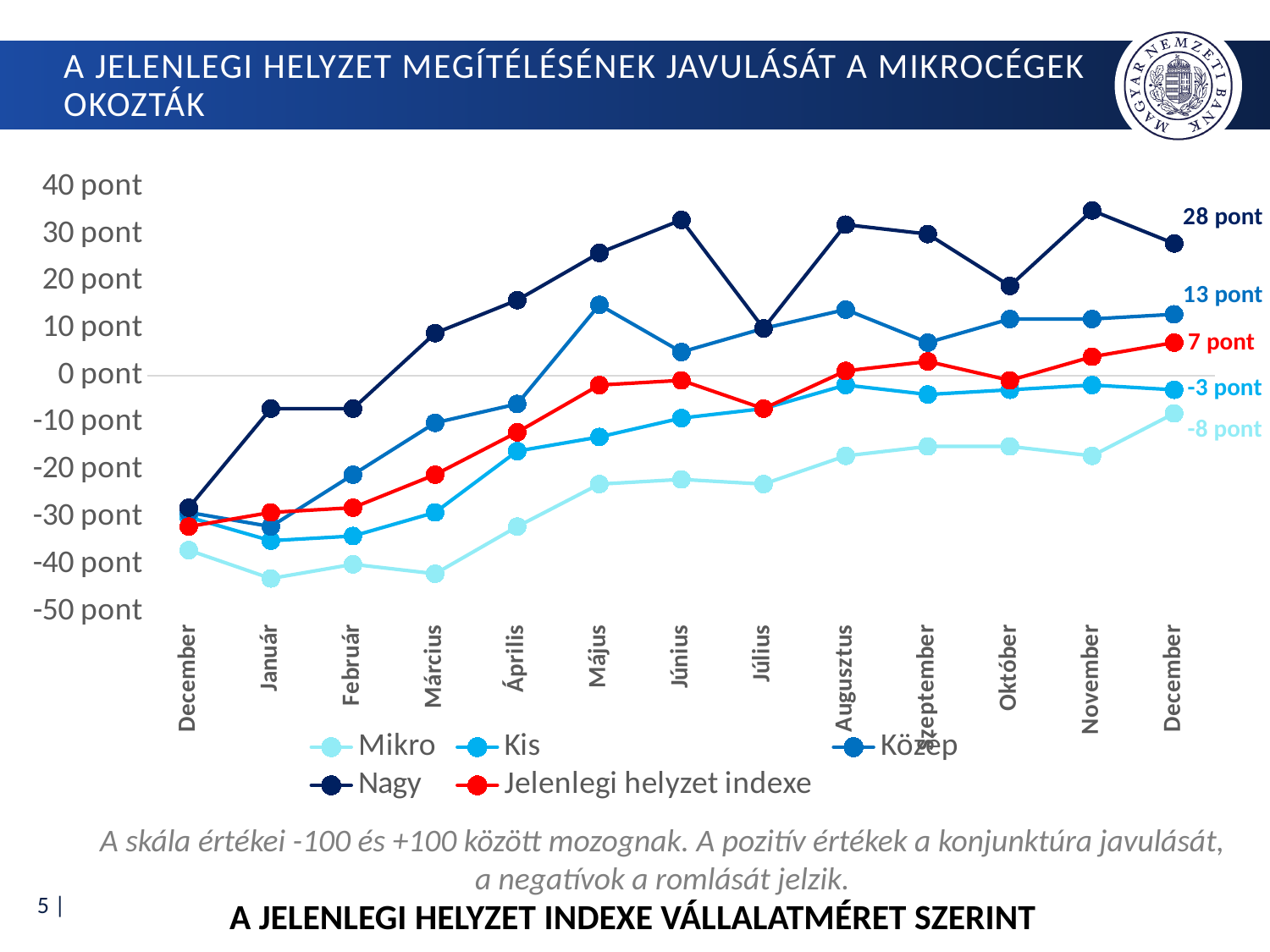
What is the value of the Jelenlegi helyzet indexe series at the final December? 7 pont What is the value of the Közep series at the final December? 13 pont What is the value of the Nagy series at the final December? 28 pont Which series has the lowest value at the final December? Mikro What is the difference between the Nagy and Közep values at the final December? 15 pont How many series does the legend list? 5 Which series has the highest value at the final December? Nagy How many months are plotted along the x axis? 13 What is the value of the Mikro series at the final December? -8 pont Is the value of the Nagy series in Június greater or less than 30 pont? greater What kind of chart is shown on the slide? line chart Does the Mikro series generally rise or fall from the first December to the last December? rise